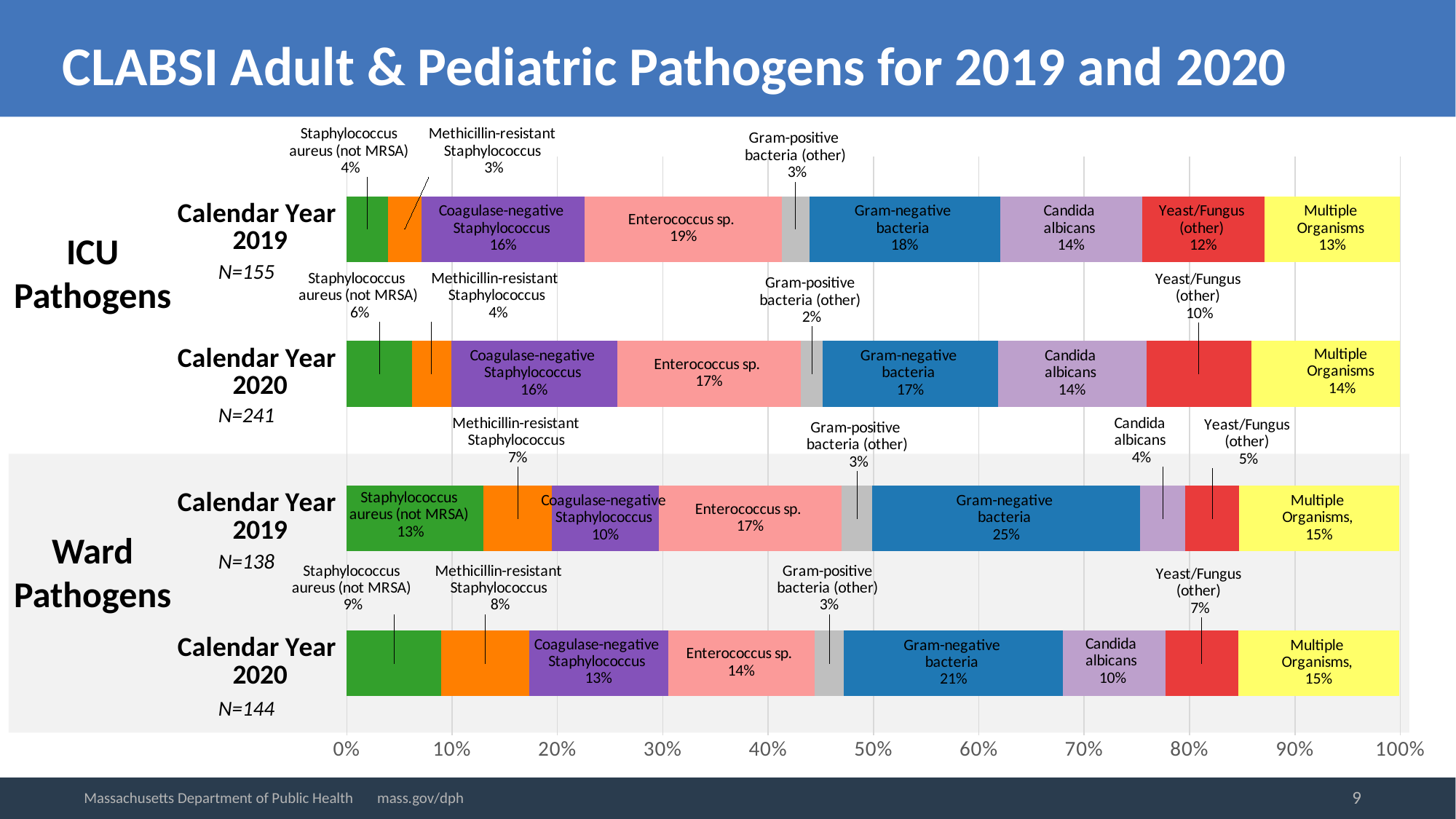
Which pathogen category had the smallest share of ICU pathogens in Calendar Year 2020? Gram-positive bacteria (other) How many calendar-year bars are plotted on the chart? 4 What percentage of Ward pathogens in Calendar Year 2020 was Candida albicans? 10% What is the N value for ICU pathogens in Calendar Year 2020? N=241 What is the difference between the Staphylococcus aureus (not MRSA) share for Ward pathogens in 2019 and in 2020? 4% Which pathogen category had the largest share of Ward pathogens in Calendar Year 2019? Gram-negative bacteria What percentage of ICU pathogens in Calendar Year 2019 was Enterococcus sp.? 19% What kind of chart is shown on the slide? Stacked bar chart Which was larger for ICU pathogens in Calendar Year 2019: the share of Candida albicans or the share of Yeast/Fungus (other)? Candida albicans What percentage of ICU pathogens in Calendar Year 2020 was Yeast/Fungus (other)? 10% What percentage of Ward pathogens in Calendar Year 2019 was Gram-negative bacteria? 25% What is the difference between the Gram-negative bacteria share for Ward pathogens in 2019 and in 2020? 4%